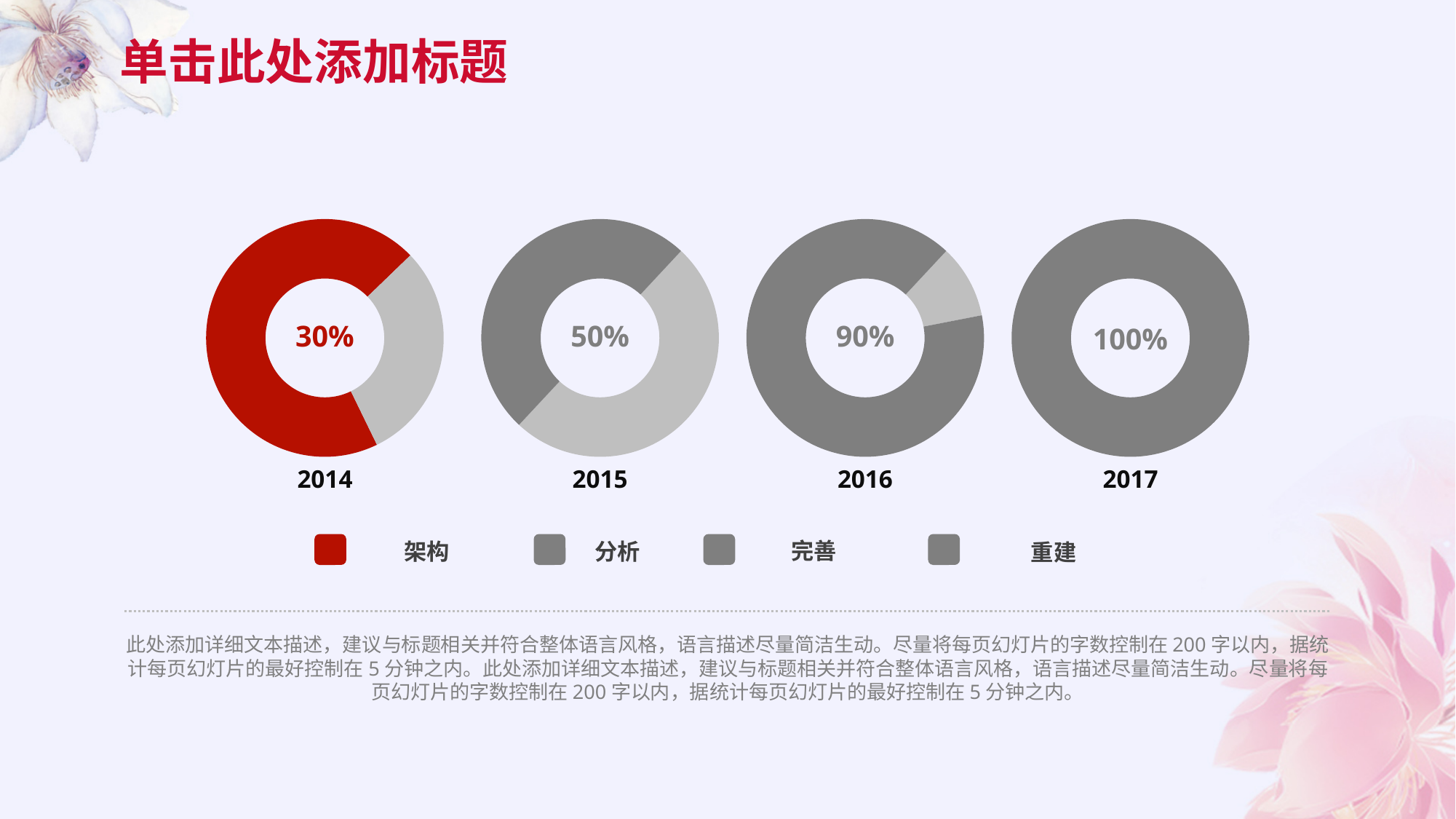
What value is shown in the centre of the 2016 donut chart? 90% How many donut charts are on the slide? 4 Do the percentages shown in the donut charts rise or fall from 2014 to 2017? rise What is the difference between the percentage shown for 2016 and the percentage shown for 2014? 60% What kind of charts are shown on the slide? donut charts Which shows a larger percentage, the 2015 donut chart or the 2016 donut chart? 2016 How many entries does the legend below the charts list? 4 What value is shown in the centre of the 2014 donut chart? 30% What value is shown in the centre of the 2017 donut chart? 100% What value is shown in the centre of the 2015 donut chart? 50% Which year's donut chart shows the lowest percentage? 2014 Which year's donut chart shows the highest percentage? 2017